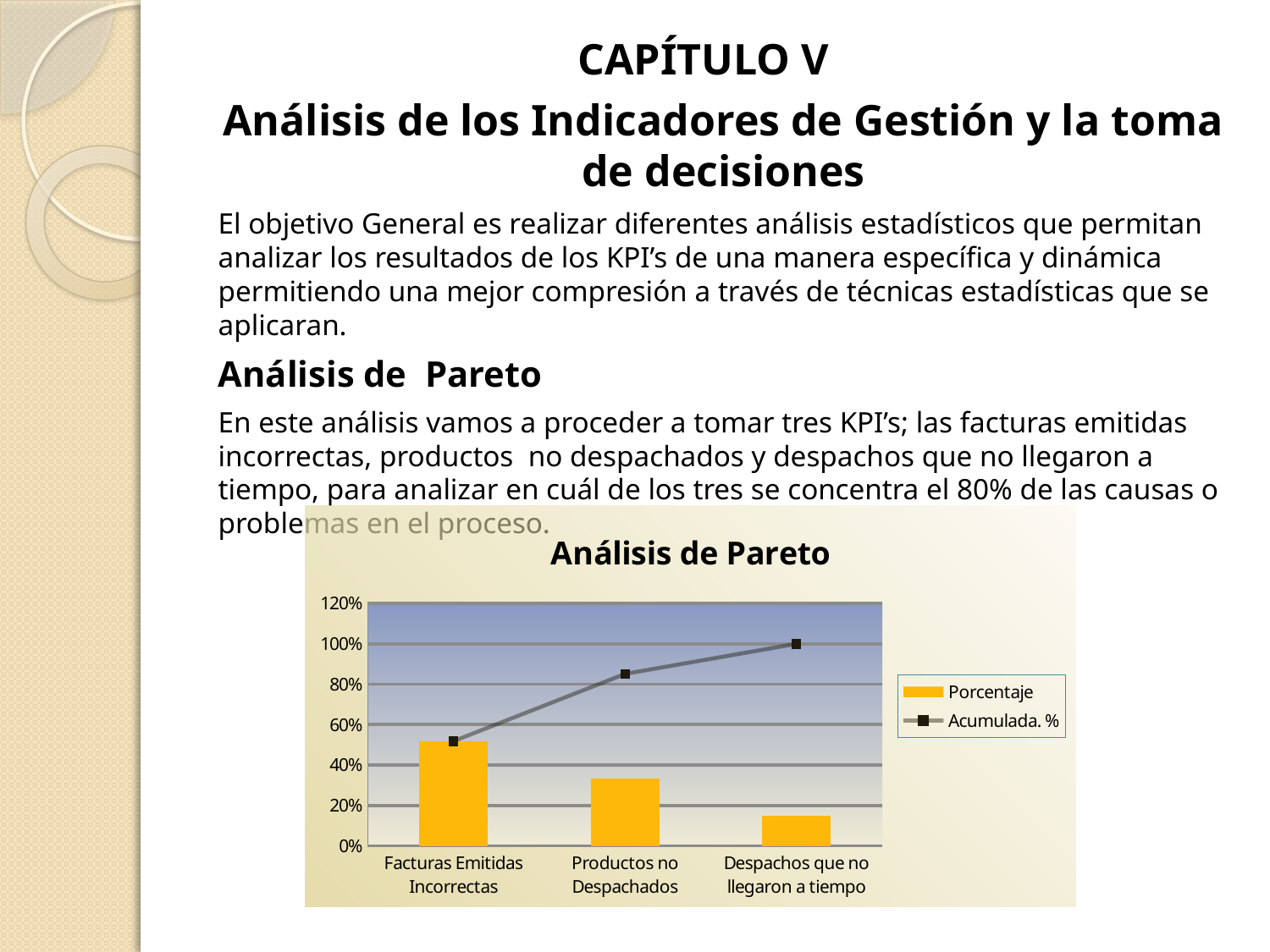
Which category has the highest Porcentaje bar? Facturas Emitidas Incorrectas What kind of chart is shown on the slide? A combined bar and line chart How many categories are shown on the x axis? 3 Is the Porcentaje value for Facturas Emitidas Incorrectas greater or less than 40%? greater Which category has the lowest Porcentaje bar? Despachos que no llegaron a tiempo Which has a larger Porcentaje value, Productos no Despachados or Despachos que no llegaron a tiempo? Productos no Despachados Is the Porcentaje value for Despachos que no llegaron a tiempo greater or less than 20%? less Do the Porcentaje bars rise or fall from left to right along the x axis? fall What is the Acumulada. % value for Despachos que no llegaron a tiempo? 100% How many series does the legend list? 2 What is the title of the chart? Análisis de Pareto What are the two series named in the legend? Porcentaje and Acumulada. %